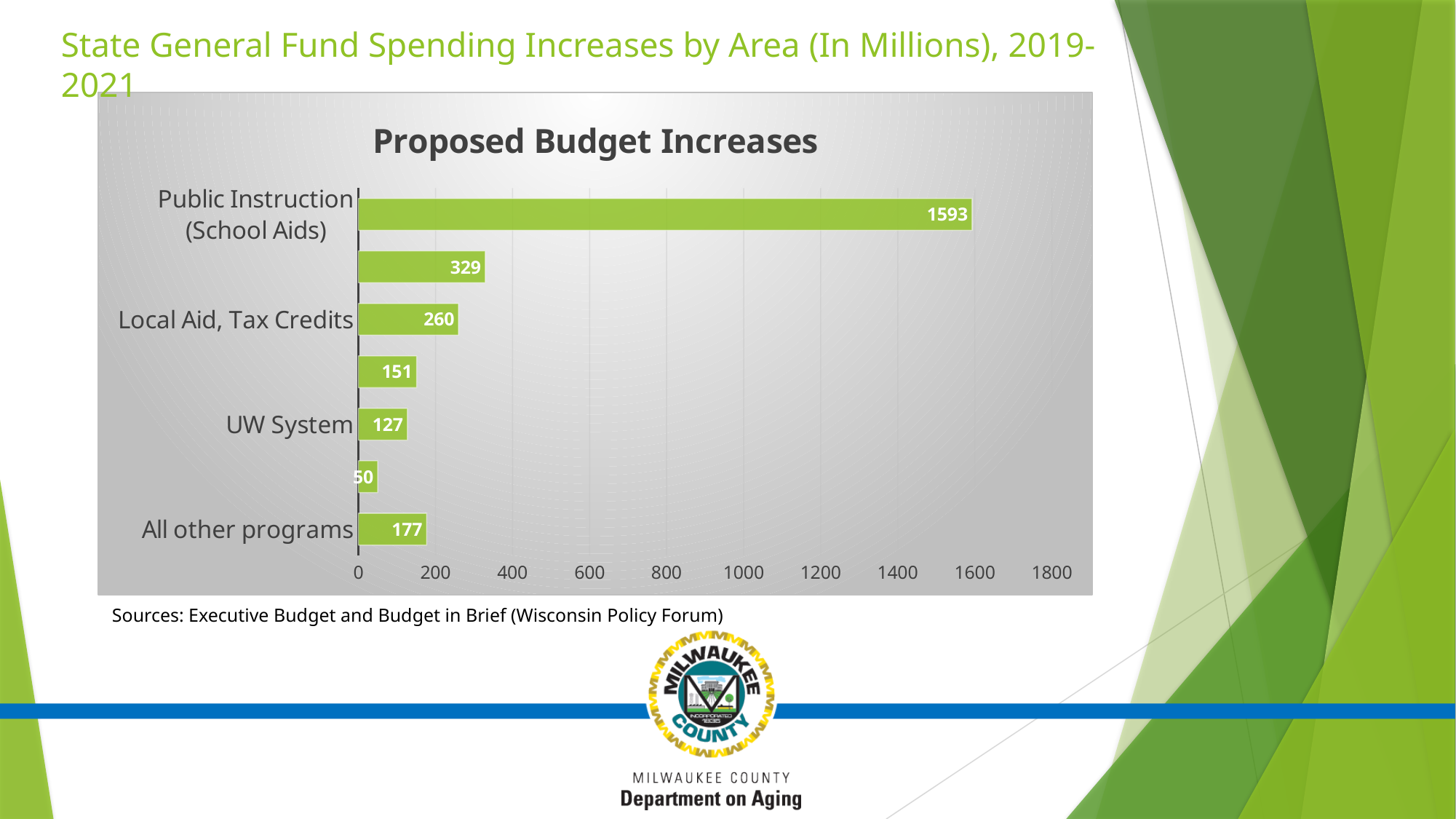
Which category has the highest value? Public Instruction (School Aids) What is the value for Local Aid, Tax Credits? 260 What is the smallest value labeled on any bar in the chart? 50 What type of chart is shown on the slide? bar chart What is the value for UW System? 127 What is the value for Public Instruction (School Aids)? 1593 What is the value for All other programs? 177 What is the difference between the values for Public Instruction (School Aids) and Local Aid, Tax Credits? 1333 Which is larger, the value for All other programs or the value for UW System? All other programs Is the value for Public Instruction (School Aids) greater or less than 1400? greater What is the title of the chart? Proposed Budget Increases How many bars are plotted in the chart? 7